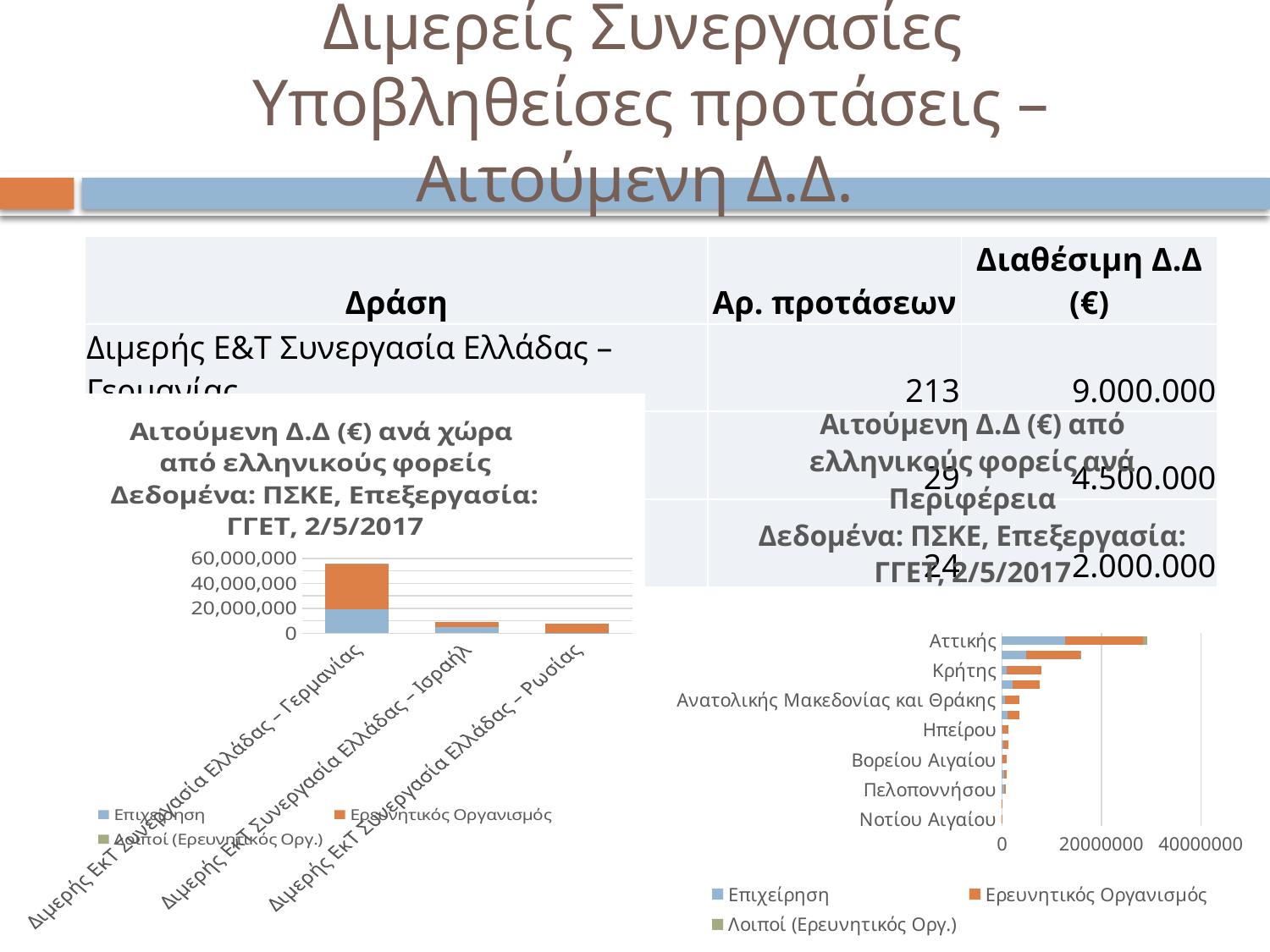
What kind of chart is the right chart titled 'Αιτούμενη Δ.Δ (€) από ελληνικούς φορείς ανά Περιφέρεια'? Bar chart In the right chart (ανά Περιφέρεια), which is larger: the total for Αττικής or the total for Κρήτης? Αττικής In the left chart (ανά χώρα), is the total for Διμερής Ε&Τ Συνεργασία Ελλάδας – Ισραήλ greater or less than 20,000,000? less In the right chart (ανά Περιφέρεια), how many series does the legend list? 3 In the right chart (ανά Περιφέρεια), is the total for Αττικής greater or less than 20000000? greater In the left chart (ανά χώρα), which is larger: the total for Ελλάδας – Γερμανίας or the total for Ελλάδας – Ρωσίας? Ελλάδας – Γερμανίας In the right chart (ανά Περιφέρεια), which region has the highest total requested funding? Αττικής What kind of chart is the left chart titled 'Αιτούμενη Δ.Δ (€) ανά χώρα από ελληνικούς φορείς'? Bar chart In the left chart (ανά χώρα), how many series does the legend list? 3 In the left chart (ανά χώρα), which category has the highest total requested funding? Διμερής Ε&Τ Συνεργασία Ελλάδας – Γερμανίας In the left chart (ανά χώρα), how many categories are shown on the x axis? 3 In the left chart (ανά χώρα), is the total for Διμερής Ε&Τ Συνεργασία Ελλάδας – Γερμανίας greater or less than 40,000,000? greater